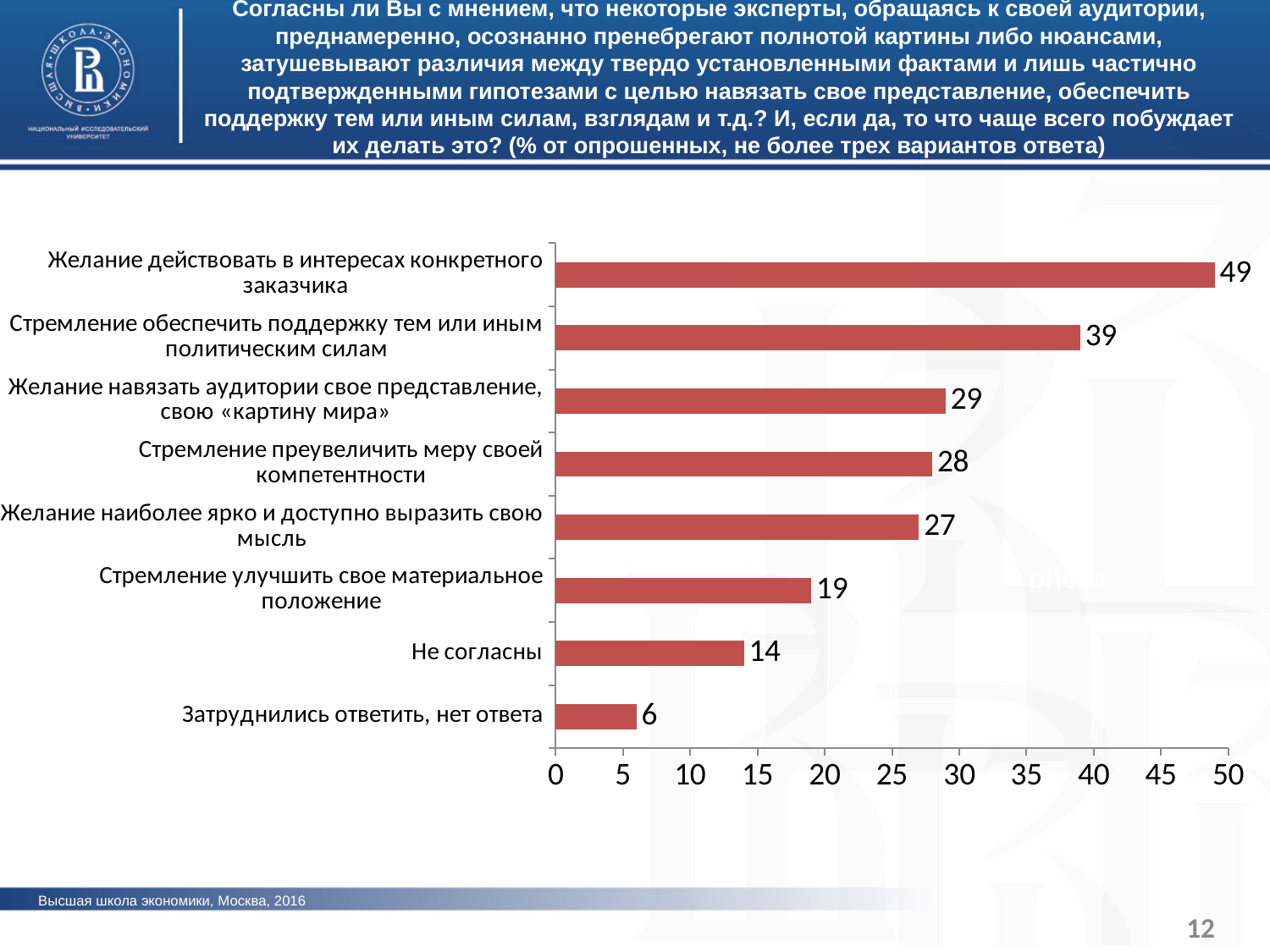
What is the value for «Стремление улучшить свое материальное положение»? 19 Which category has the highest value? Желание действовать в интересах конкретного заказчика What is the value for «Желание действовать в интересах конкретного заказчика»? 49 What is the value for «Не согласны»? 14 Which category has the lowest value? Затруднились ответить, нет ответа Which is larger: «Стремление преувеличить меру своей компетентности» or «Стремление улучшить свое материальное положение»? Стремление преувеличить меру своей компетентности What is the difference between «Желание действовать в интересах конкретного заказчика» and «Стремление обеспечить поддержку тем или иным политическим силам»? 10 How many categories are shown in the chart? 8 What kind of chart is shown on the slide? bar chart Is the value for «Стремление обеспечить поддержку тем или иным политическим силам» greater or less than 35? greater What is the maximum value shown on the horizontal axis? 50 What is the difference between «Желание навязать аудитории свое представление, свою «картину мира»» and «Затруднились ответить, нет ответа»? 23